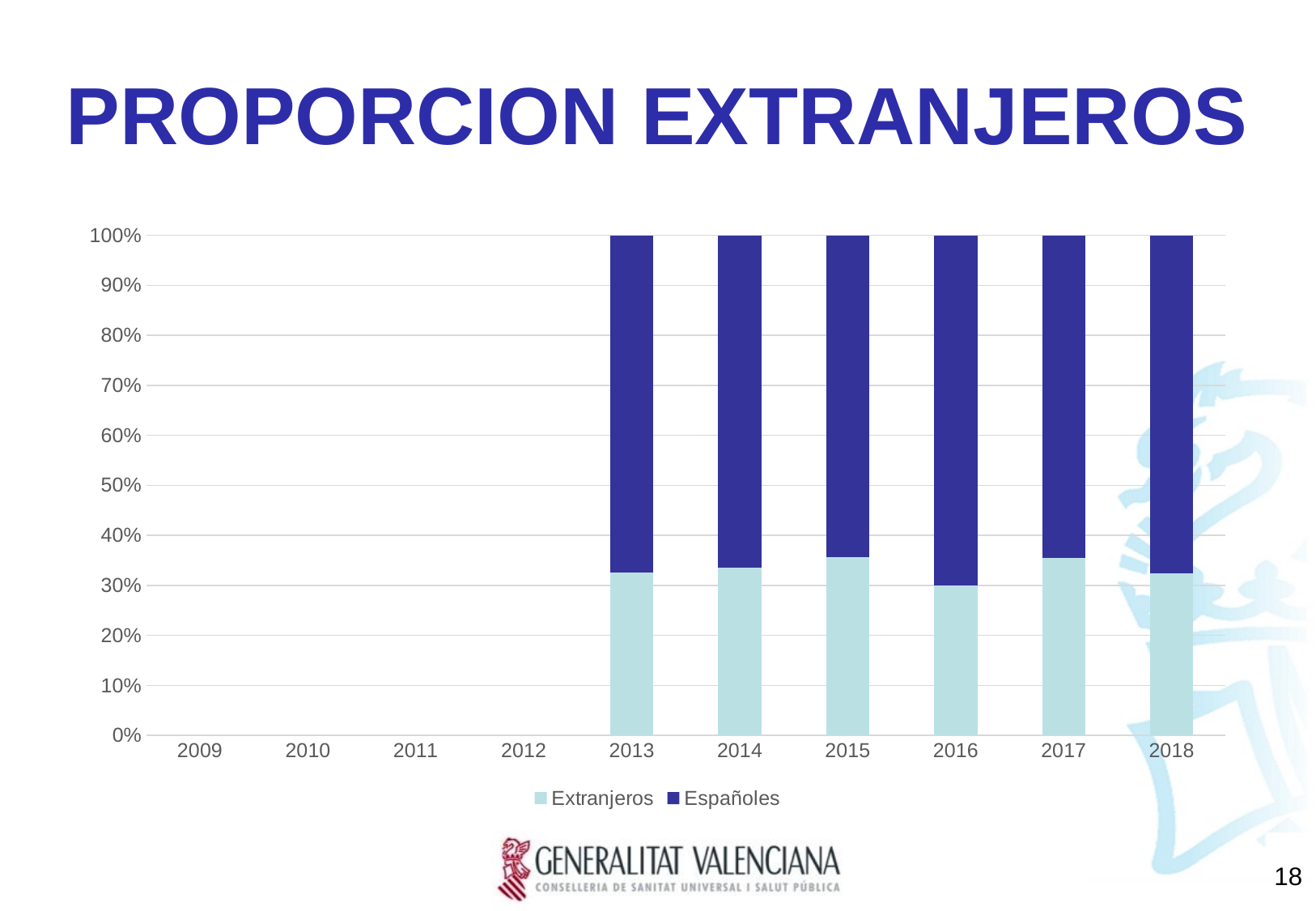
Which year has the larger Españoles share, 2016 or 2017? 2016 Which year has the lowest Extranjeros share among the plotted years? 2016 How many years on the x axis have bars plotted? 6 Which series is shown in dark blue in the chart? Españoles How many series does the chart legend list? 2 What is the total height of the stacked bar for 2014? 100% What kind of chart is shown on the slide? Stacked bar chart Is the Españoles share for 2013 greater or less than 60%? greater Which year has the larger Extranjeros share, 2015 or 2016? 2015 What is the title of the chart on the slide? PROPORCION EXTRANJEROS Is the Extranjeros value for 2015 greater or less than 30%? greater Is the Extranjeros value for 2014 greater or less than 40%? less